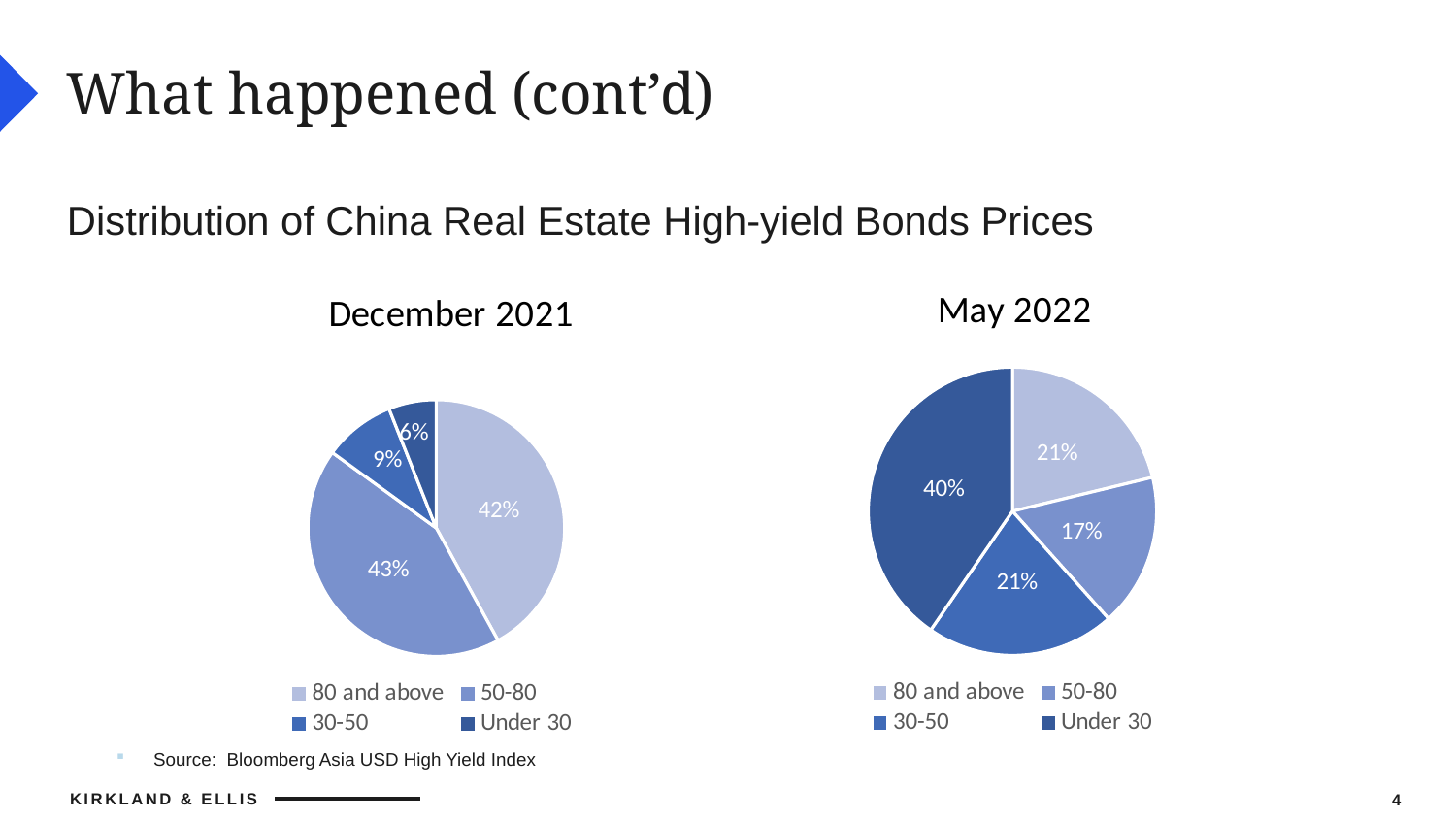
What is the source cited for the charts on the slide? Bloomberg Asia USD High Yield Index How many price buckets does each pie chart show? 4 In the May 2022 pie chart, which price bucket has the largest share? Under 30 In the May 2022 pie chart, which price bucket has the smallest share? 50-80 In the May 2022 pie chart, what share of bonds were priced Under 30? 40% What is the difference between the Under 30 share in May 2022 and the Under 30 share in December 2021? 34 percentage points In the December 2021 pie chart, which price bucket has the smallest share? Under 30 In the December 2021 pie chart, what share of bonds were priced 80 and above? 42% In the December 2021 pie chart, what share of bonds were priced 50-80? 43% What type of chart is used to show the December 2021 distribution? Pie chart In the May 2022 pie chart, what share of bonds were priced 50-80? 17% In the December 2021 pie chart, which is larger: the 30-50 share or the Under 30 share? 30-50